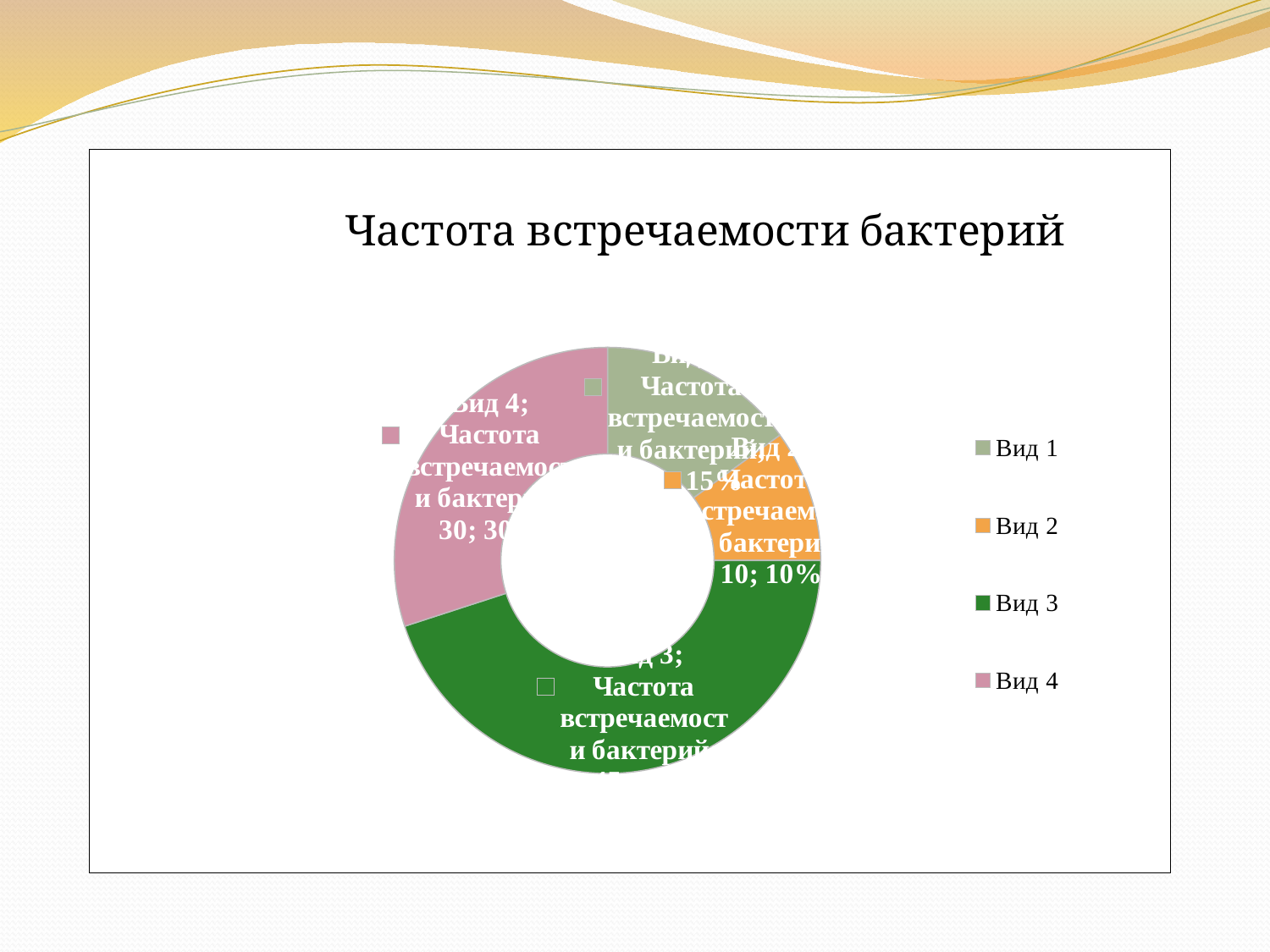
What is the value for Вид 4? 30 What kind of chart is shown on the slide? Doughnut (pie) chart What share of the chart does Вид 4 represent? 30% What share of the chart does Вид 2 represent? 10% Which category has the smallest slice? Вид 2 Which category has the largest slice? Вид 3 Which categories are listed in the legend? Вид 1, Вид 2, Вид 3, Вид 4 What is the difference between the values for Вид 4 and Вид 2? 20 What is the value for Вид 2? 10 How many categories does the chart show? 4 What is the title of the chart? Частота встречаемости бактерий Which is larger, the slice for Вид 3 or the slice for Вид 4? Вид 3